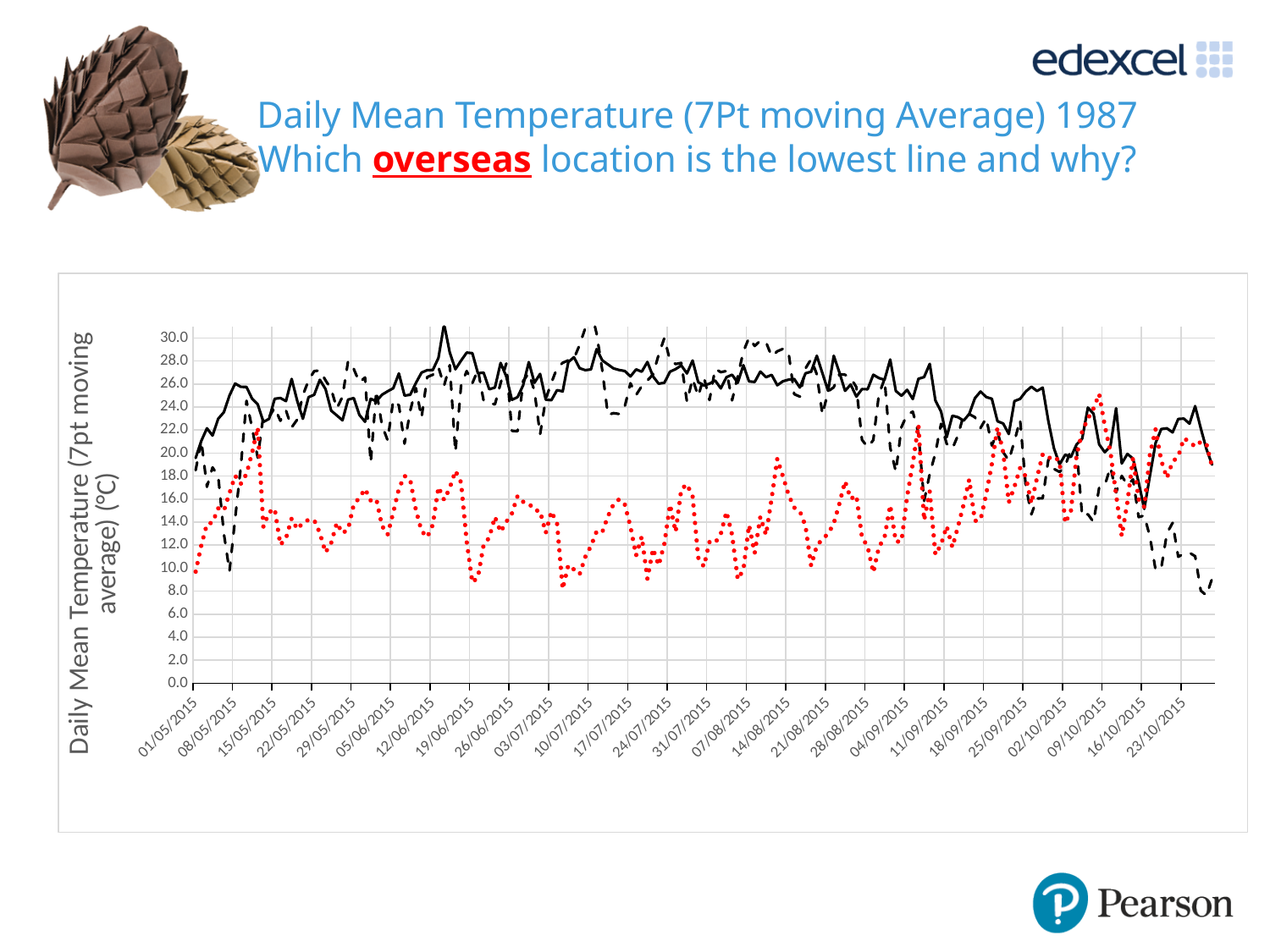
How many date labels are shown on the horizontal axis? 26 Is the peak value of the solid black line around 12/06/2015 greater or less than 30.0? greater How many lines (series) are plotted on the chart? 3 What kind of chart is shown on the slide? line chart What is the highest value shown on the vertical axis of the chart? 30.0 Is the value of the dashed black line at 23/10/2015 greater or less than 10.0? greater Which line is the lowest for most of the period from May to September: the solid black, the dashed black, or the red dotted line? red dotted line What is the label on the vertical axis of the chart? Daily Mean Temperature (7pt moving average) (°C) What is the first date shown on the horizontal axis? 01/05/2015 Does the dashed black line rise or fall between 09/10/2015 and 23/10/2015? fall Is the lowest value of the red dotted line around 19/06/2015 greater or less than 10.0? less What is the last date shown on the horizontal axis? 23/10/2015